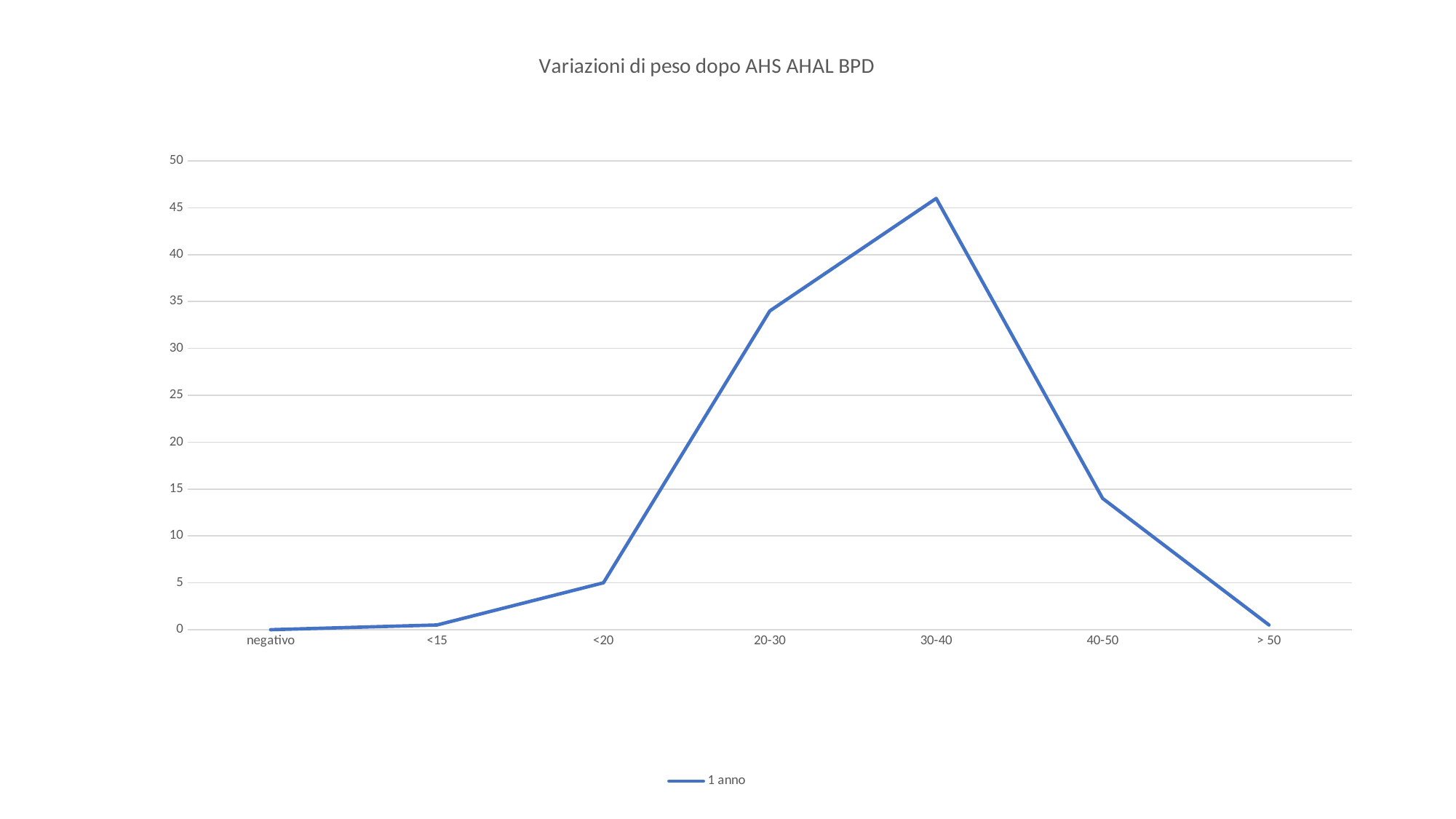
What is the title of the chart? Variazioni di peso dopo AHS AHAL BPD Is the value for <15 greater or less than 5? less Is the value for 40-50 greater or less than 15? less Do the values rise or fall from 30-40 to > 50? fall What is the name of the series shown in the legend? 1 anno How many categories are shown on the x axis? 7 Is the value for 20-30 greater or less than 30? greater Which is larger, the value for 20-30 or the value for 40-50? 20-30 What kind of chart is shown on the slide? line chart How many series does the legend list? 1 Which category has the highest value? 30-40